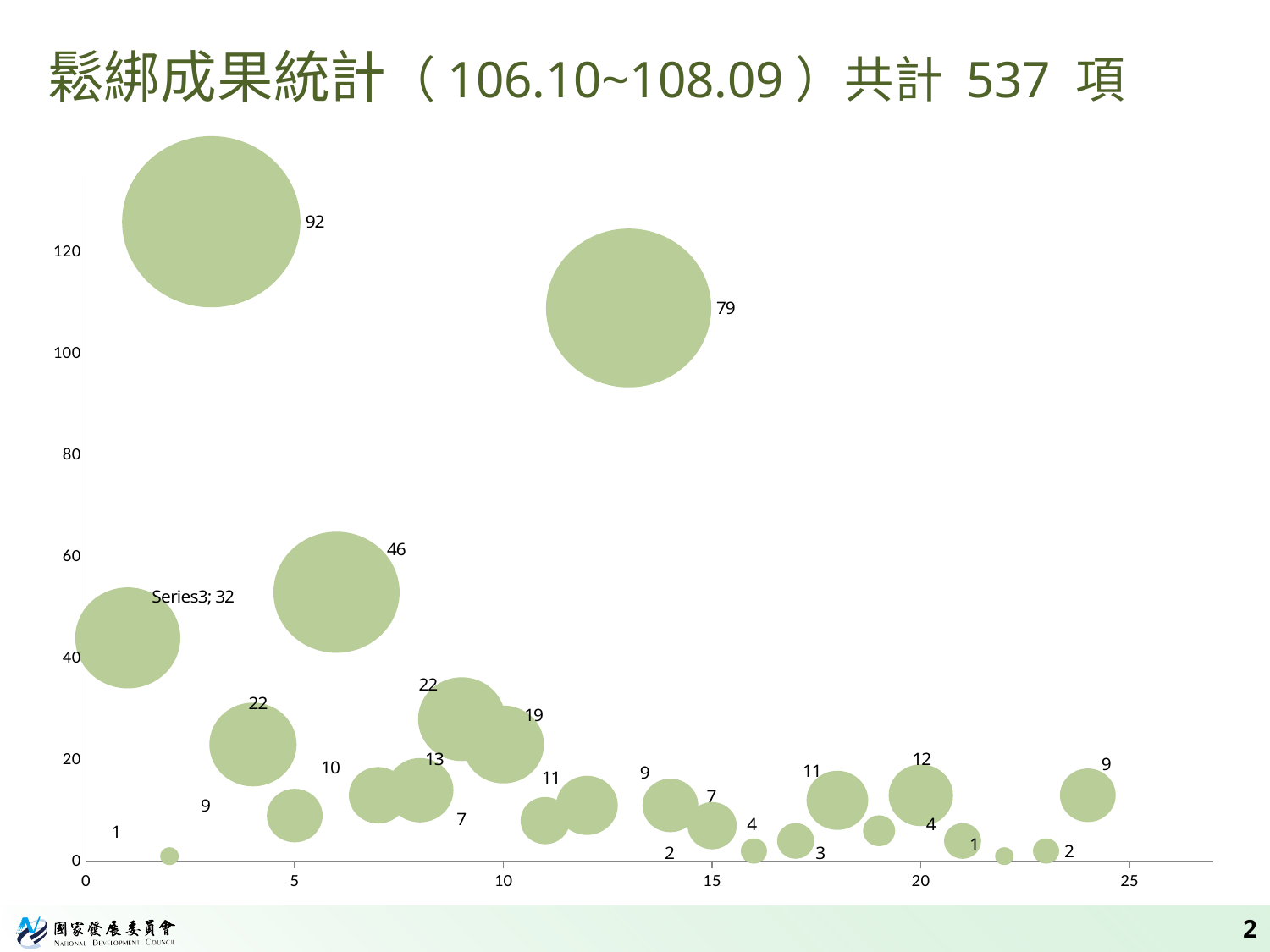
What is the second-largest value labelled on a bubble in the chart? 79 Is the vertical position of the bubble labelled 92 greater or less than 120 on the y axis? greater According to the slide title, what is the total number of items (共計) counted? 537 項 What is the highest tick value shown on the x axis of the chart? 25 What is the smallest value labelled on any bubble in the chart? 1 What is the largest value labelled on any bubble in the chart? 92 Which is larger: the bubble labelled 46 or the bubble labelled Series3; 32? 46 What value is labelled for Series3 in the chart? 32 What kind of chart is shown on the slide? bubble chart What is the difference between the bubble labelled 46 and the bubble labelled Series3; 32? 14 Is the vertical position of the bubble labelled 79 greater or less than 120 on the y axis? less What is the difference between the two largest labelled bubble values, 92 and 79? 13